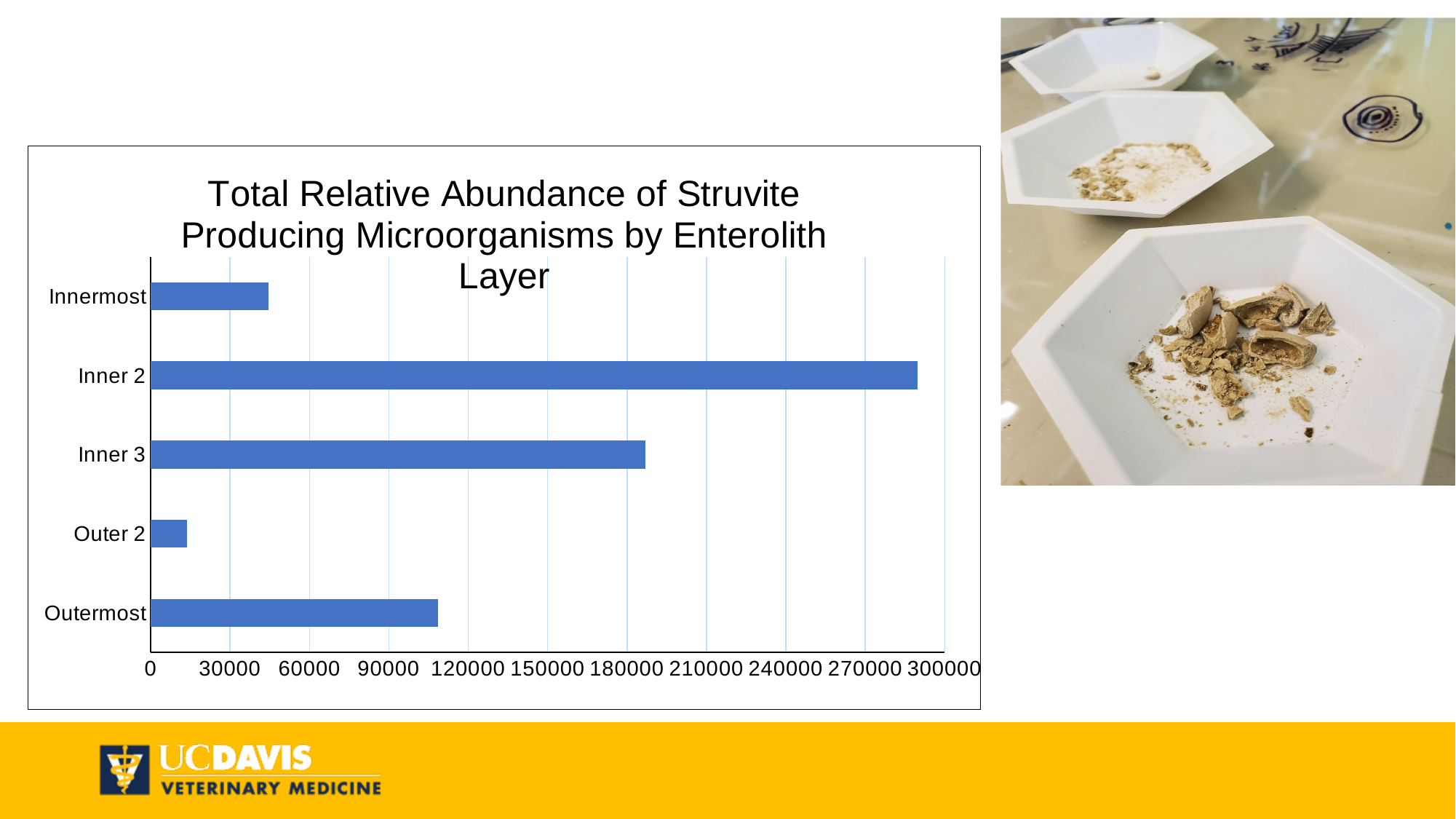
Is the value for Outer 2 greater or less than 30000? less How many enterolith layers are plotted in the chart? 5 Is the value for Inner 2 greater or less than 270000? greater Is the value for Inner 3 greater or less than 150000? greater What kind of chart is shown on the slide? bar chart Which has a larger total relative abundance, Innermost or Outer 2? Innermost Which enterolith layer has the highest total relative abundance of struvite producing microorganisms? Inner 2 What is the title of the chart? Total Relative Abundance of Struvite Producing Microorganisms by Enterolith Layer Which has a larger total relative abundance, Inner 3 or Outermost? Inner 3 Which enterolith layer has the lowest total relative abundance of struvite producing microorganisms? Outer 2